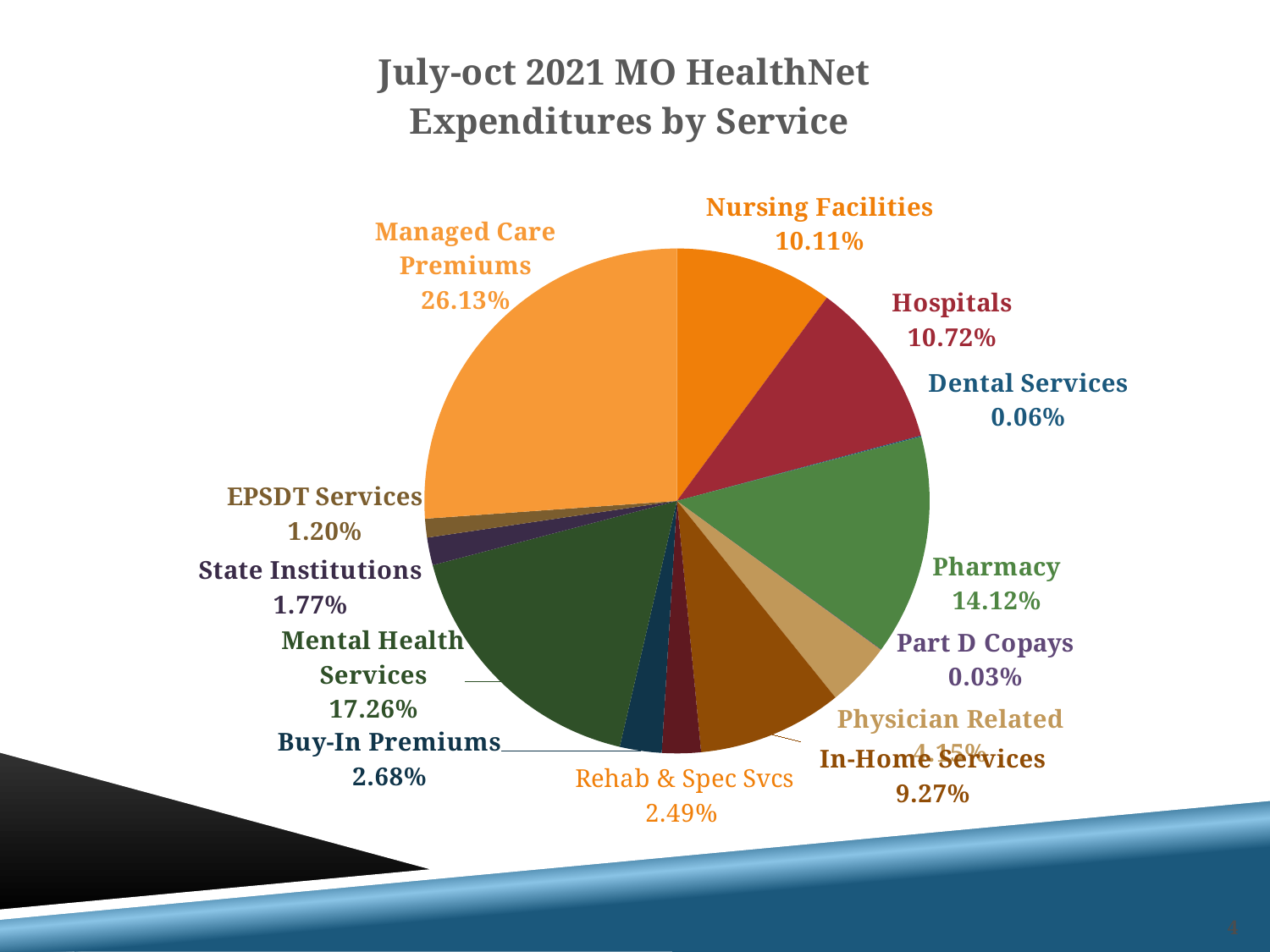
What kind of chart is shown on the slide? pie chart What percentage is shown for Mental Health Services? 17.26% Which service category has the smallest share of expenditures? Part D Copays What percentage is shown for In-Home Services? 9.27% What share of expenditures is Managed Care Premiums? 26.13% What is the difference between the Hospitals share and the Nursing Facilities share? 0.61% How many service categories are shown in the pie chart? 13 What is the value for Pharmacy? 14.12% What is the title of the chart? July-oct 2021 MO HealthNet Expenditures by Service Which is larger, Buy-In Premiums or Rehab & Spec Svcs? Buy-In Premiums Which service category has the largest share of expenditures? Managed Care Premiums What is the value for Dental Services? 0.06%